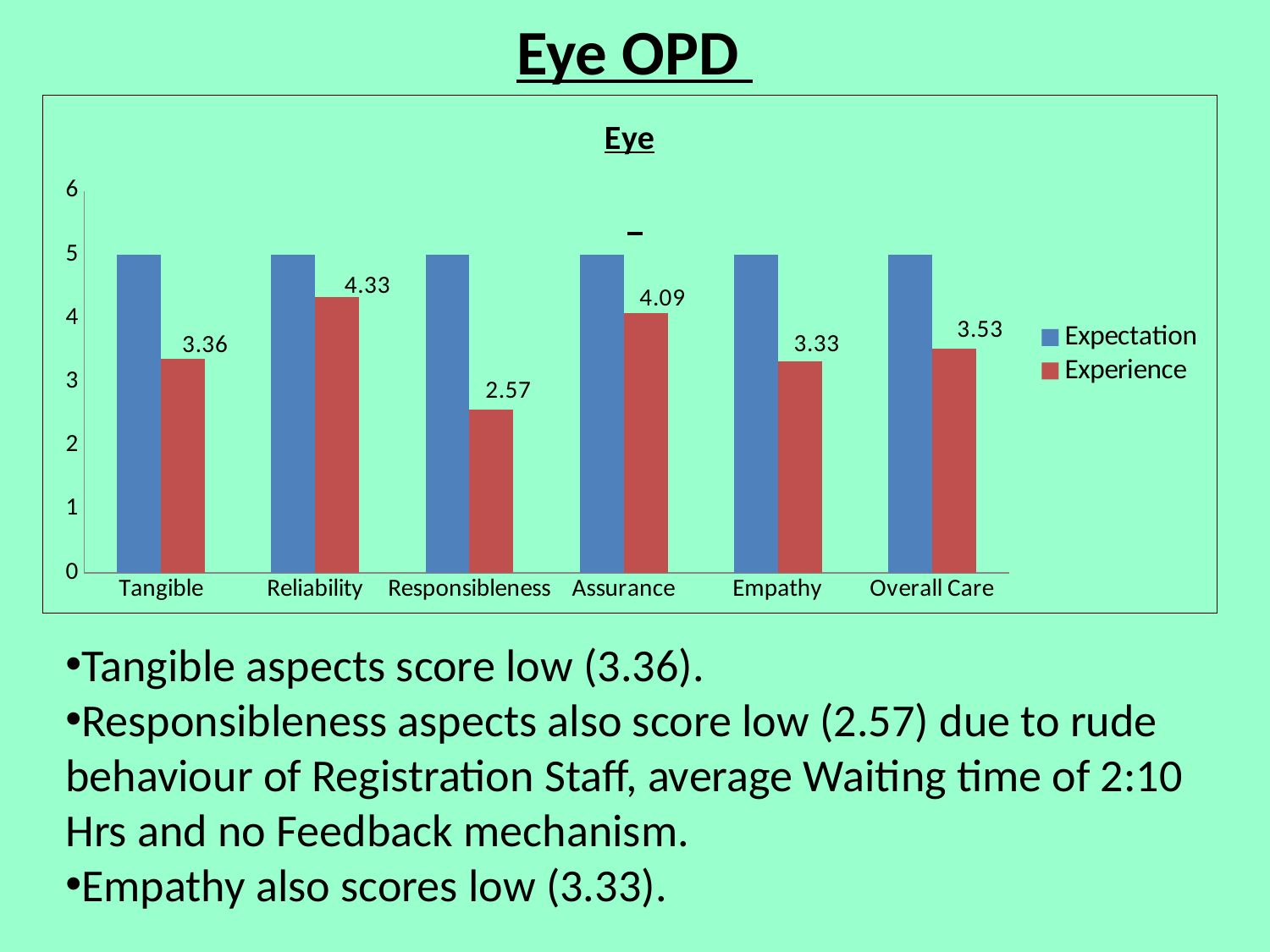
How many categories are shown on the x axis? 6 What is the Experience value for Assurance? 4.09 Which category has the highest Experience value? Reliability Which category has the lowest Experience value? Responsibleness Is the Expectation value for Tangible greater or less than 4? greater Which is larger, the Experience value for Assurance or for Empathy? Assurance What is the Experience value for Overall Care? 3.53 What is the Experience value for Reliability? 4.33 What is the Experience value for Responsibleness? 2.57 What kind of chart is shown? bar chart What is the difference between the Experience values for Reliability and Responsibleness? 1.76 How many series does the legend list? 2